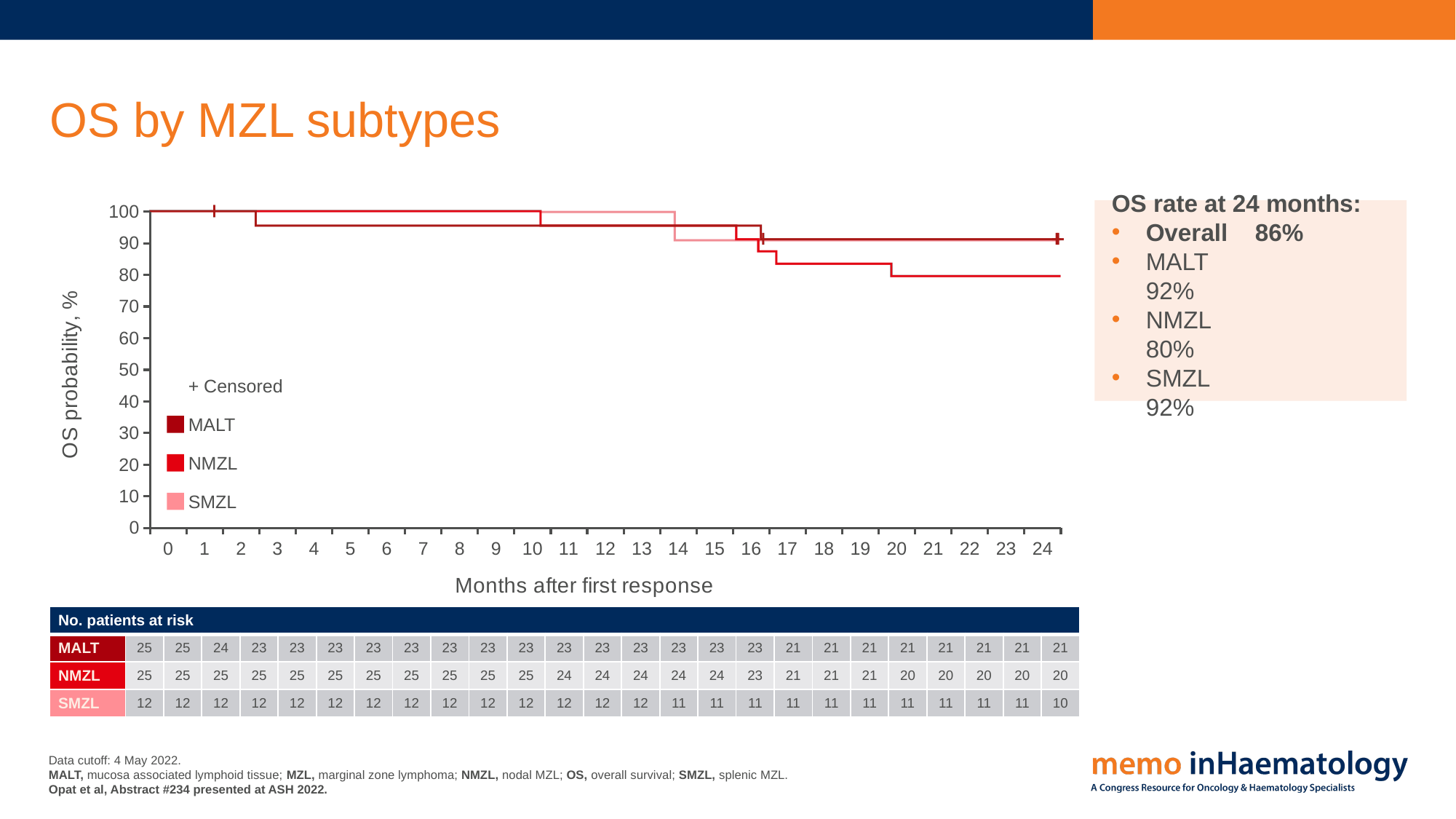
What is the OS rate at 24 months for NMZL? 80% How many SMZL patients were at risk at month 0? 12 Do the OS probability curves rise or fall as months after first response increase? fall What is the OS rate at 24 months for MALT? 92% How many NMZL patients were at risk at month 24? 20 How many subtype series does the chart legend list? 3 Which MZL subtype has the lowest OS rate at 24 months? NMZL What kind of chart is shown on the slide? line chart What is the difference between the 24-month OS rate for MALT and for NMZL? 12% What is the overall OS rate at 24 months? 86% Which has the higher OS rate at 24 months, MALT or NMZL? MALT Is the NMZL OS probability at month 20 greater or less than 90? less